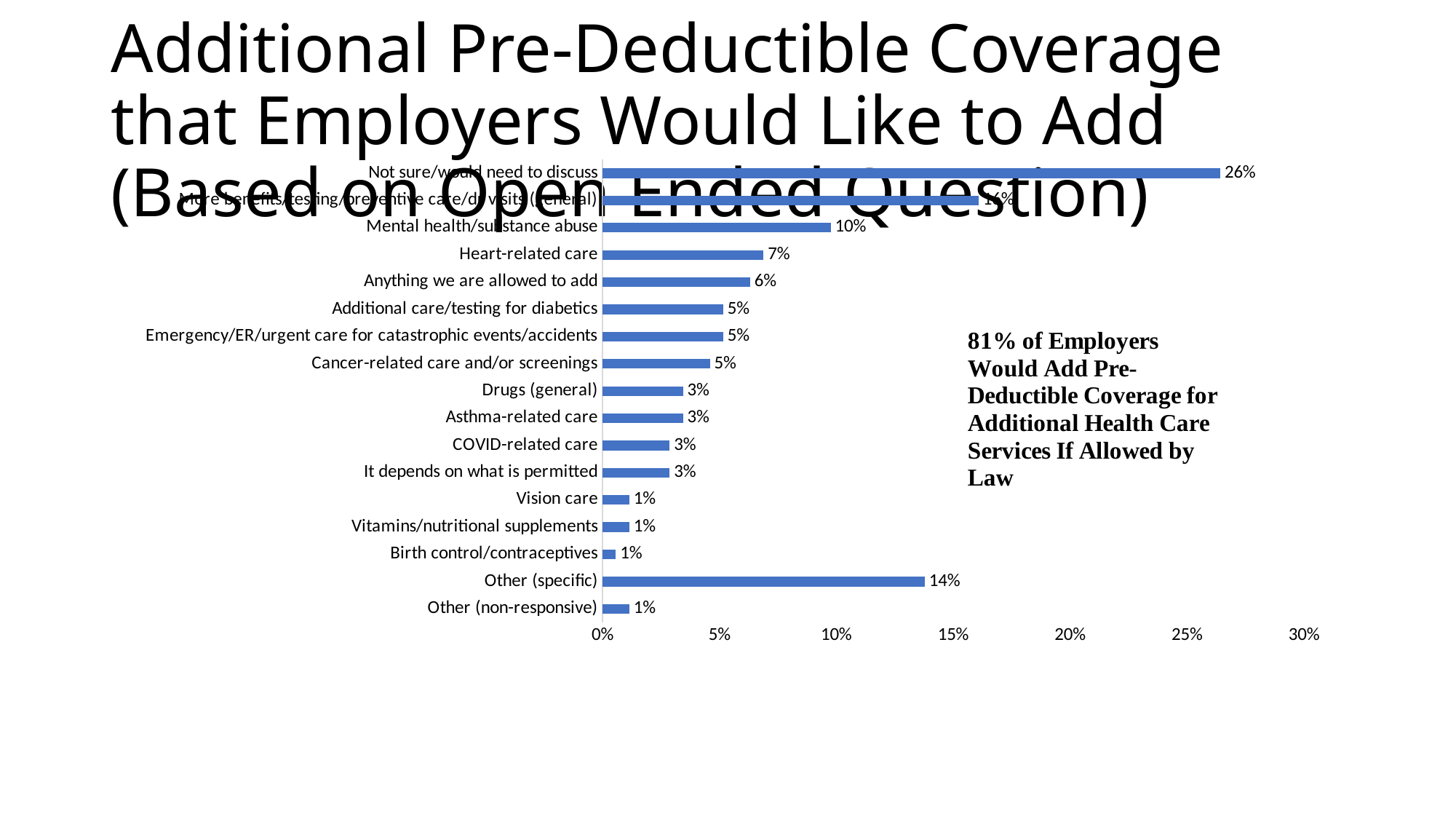
What is the difference between the values for "Not sure/would need to discuss" and "Other (specific)"? 12 percentage points What is the value for "Cancer-related care and/or screenings"? 5% Which category has the highest value in the chart? Not sure/would need to discuss Is the value for "Other (specific)" greater or less than 10%? greater According to the text box beside the chart, what percentage of employers would add pre-deductible coverage for additional health care services if allowed by law? 81% What percentage is shown for "Not sure/would need to discuss"? 26% What kind of chart is shown on the slide? bar chart Which is larger, the value for "Mental health/substance abuse" or for "Other (specific)"? Other (specific) What percentage is shown for "Heart-related care"? 7% What is the value for "Other (specific)"? 14% How many categories are plotted in the chart? 17 What is the value for "Mental health/substance abuse"? 10%